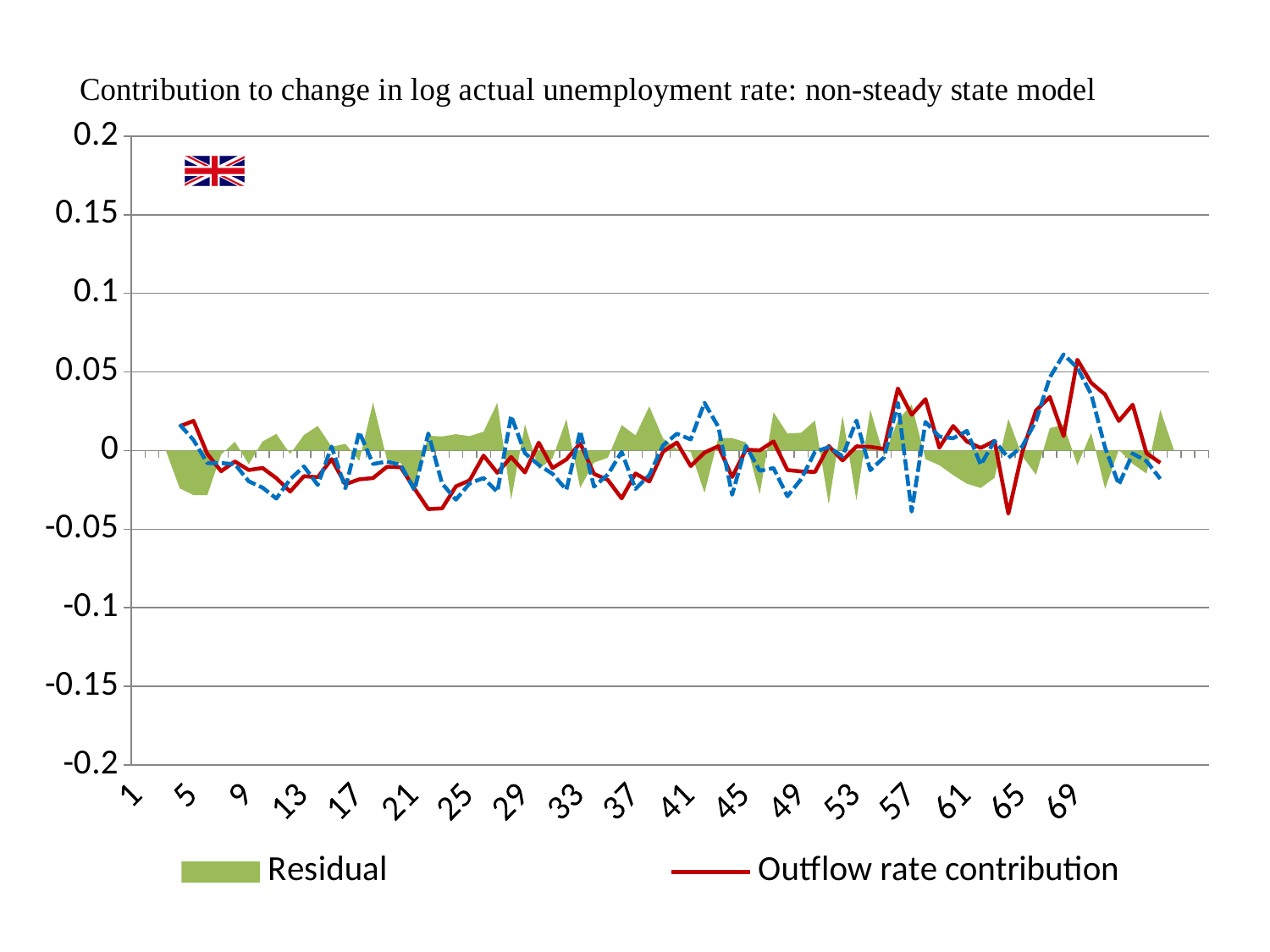
What is the highest value shown on the vertical axis? 0.2 How many series does the legend list? 2 Is the Residual value at 5 greater or less than 0? less Is the highest value of Outflow rate contribution greater or less than 0.1? less Which is larger for Outflow rate contribution: the value at 65 or the value at 69? 69 Is the lowest value of Outflow rate contribution greater or less than -0.1? greater What is the title of the chart? Contribution to change in log actual unemployment rate: non-steady state model How many tick labels are shown on the horizontal axis? 18